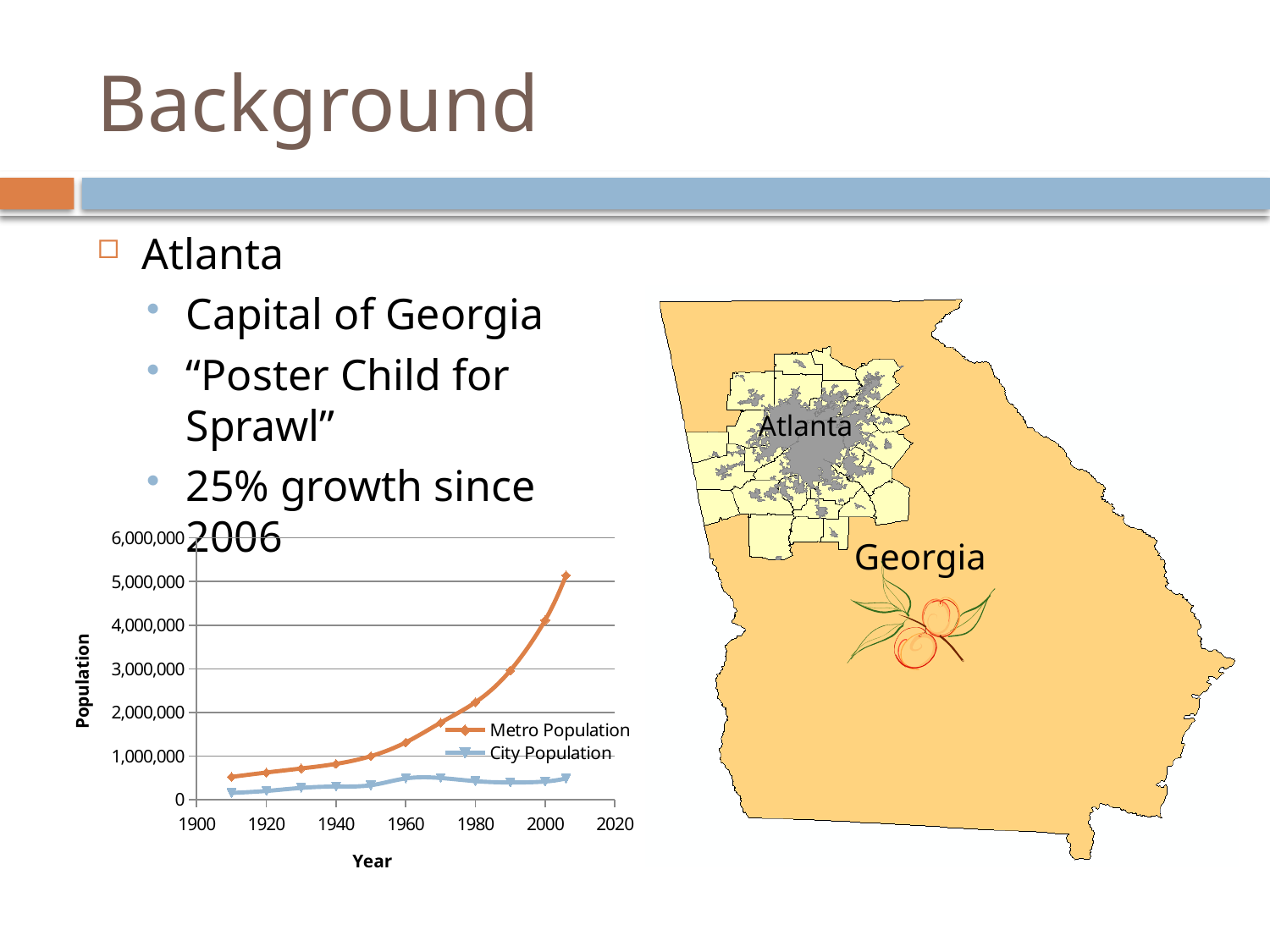
What kind of chart is shown on the slide? line chart In 2000, which series has the larger value, Metro Population or City Population? Metro Population Does the Metro Population rise or fall as the year increases? rise Is the Metro Population value for 1940 greater or less than 2,000,000? less What are the two series named in the chart's legend? Metro Population and City Population Is the Metro Population value for 1960 greater or less than 1,000,000? greater What is the title of the chart's x axis? Year How many series does the chart's legend list? 2 Is the Metro Population value for 1910 greater or less than 1,000,000? less